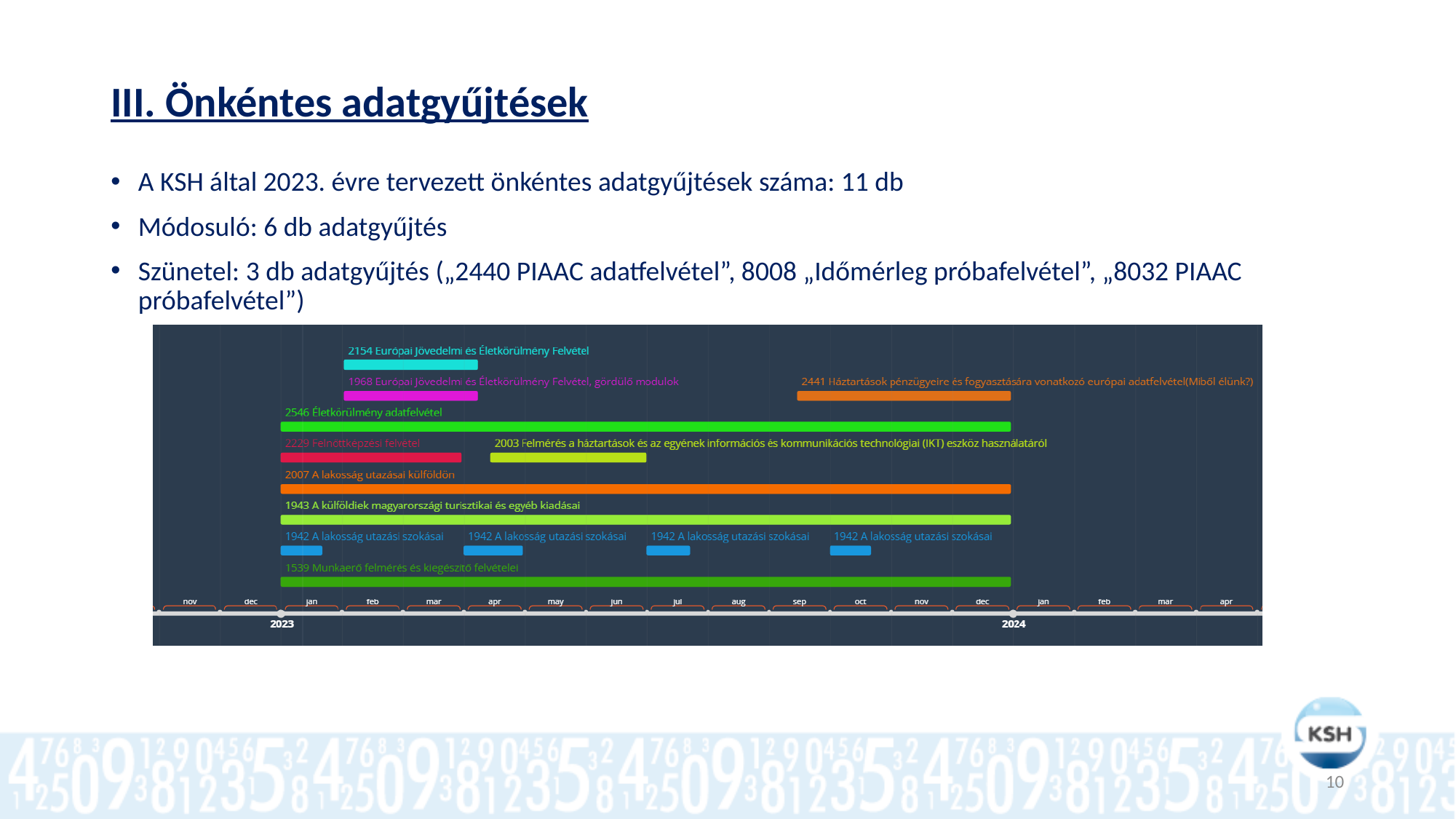
How many bars are labelled "1942 A lakosság utazási szokásai" on the timeline? 4 What colour is the bar for "2229 Felnőttképzési felvétel"? Red Which survey has the shortest bars on the timeline? 1942 A lakosság utazási szokásai Which survey label on the timeline ends with "(Miből élünk?)"? 2441 Háztartások pénzügyeire és fogyasztására vonatkozó európai adatfelvétel In which month of 2023 does the bar for "2441 Háztartások pénzügyeire és fogyasztására vonatkozó európai adatfelvétel" start? sep Which survey is shown in the top row of the timeline? 2154 Európai Jövedelmi és Életkörülmény Felvétel Which survey starts later on the timeline, 2003 (IKT eszköz használat) or 2441 (Háztartások pénzügyeire)? 2441 Which two year markers are shown on the timeline axis? 2023 and 2024 In which month of 2023 does the bar for "2003 Felmérés a háztartások és az egyének információs és kommunikációs technológiai (IKT) eszköz használatáról" start? apr Which survey is shown in the bottom row of the timeline? 1539 Munkaerő felmérés és kiegészítő felvételei What kind of chart is shown on the slide? A timeline (Gantt) chart Which survey starts earlier on the timeline, 2154 Európai Jövedelmi és Életkörülmény Felvétel or 2441 Háztartások pénzügyeire? 2154